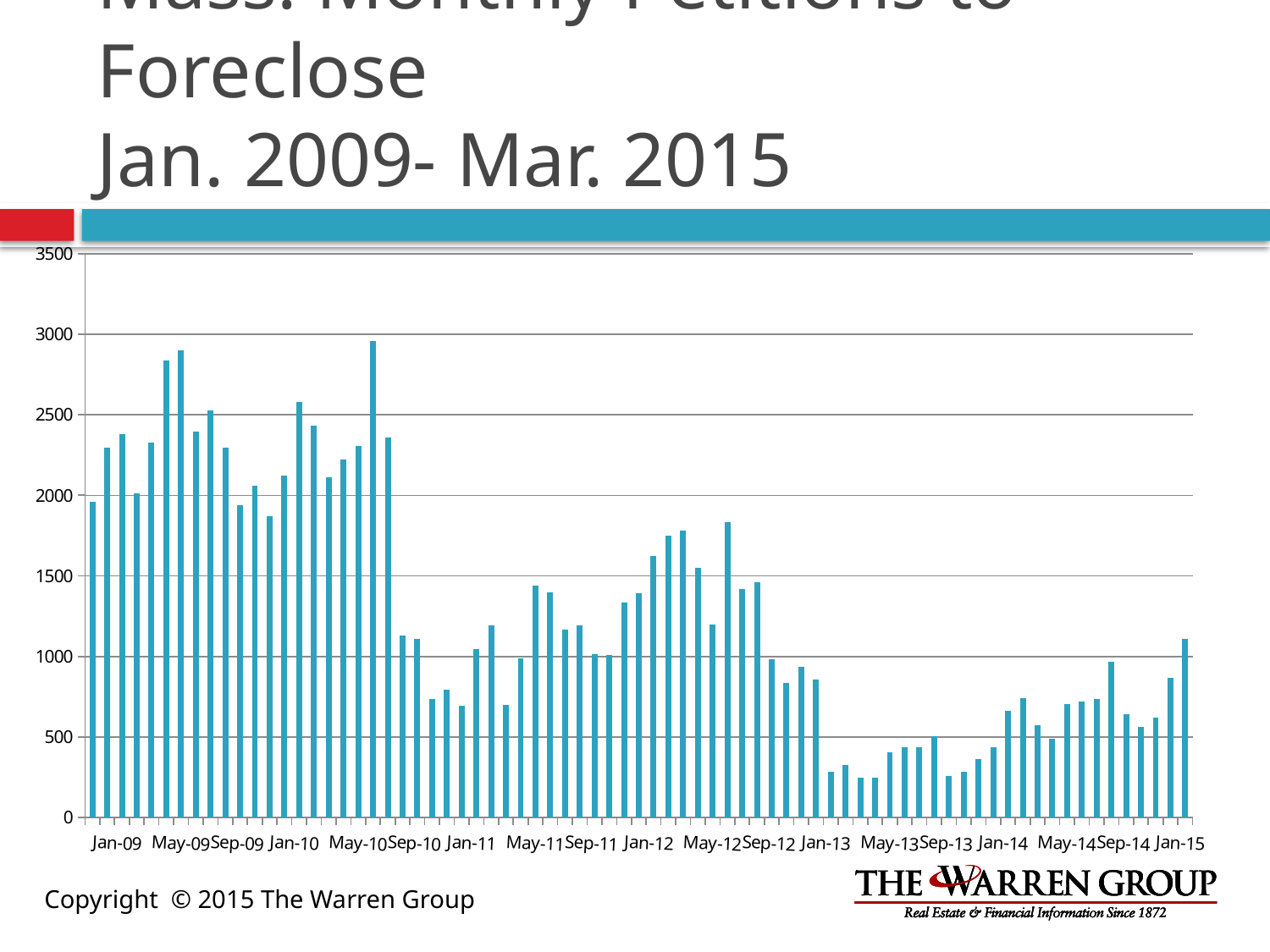
Which is larger, the value for Jan-09 or the value for Jan-13? Jan-09 Is the value for May-11 greater or less than 1000? less Is the value for Sep-13 greater or less than 500? less What kind of chart is shown on the slide? Bar chart Which is larger, the value for Jan-10 or the value for Jan-14? Jan-10 Is the value for Jan-09 greater or less than 2000? less Do the values generally rise or fall from Jan-09 to Jan-13? fall What is the highest value shown on the vertical axis? 3500